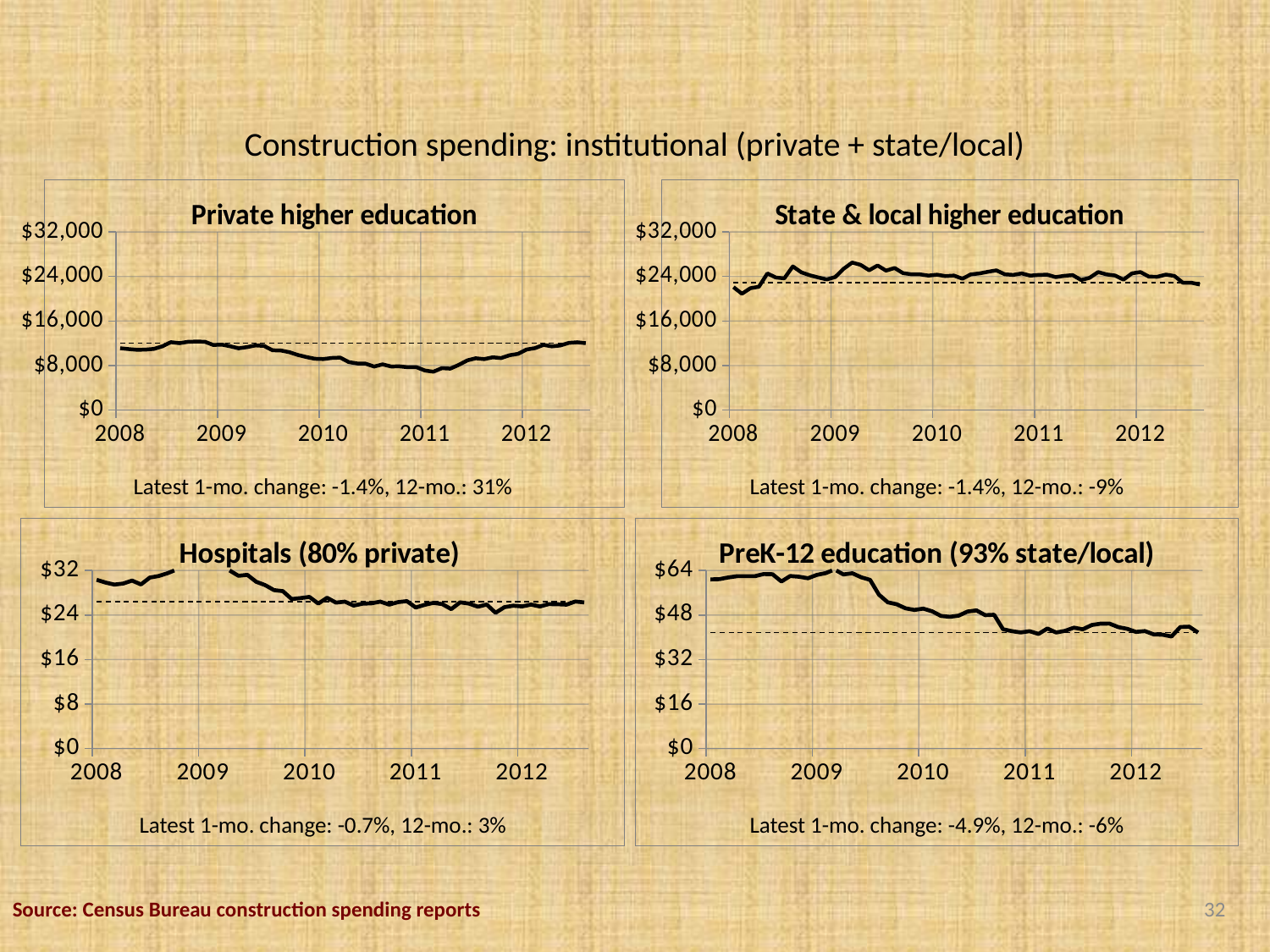
In the 'State & local higher education' chart, is the value at the start of 2010 greater or less than $16,000? greater What is the title of the chart in the bottom-left position of the slide? Hospitals (80% private) In the 'Hospitals (80% private)' chart, do values generally rise or fall from 2008 to 2012? fall In the 'Private higher education' chart, is the value at the start of 2008 greater or less than $8,000? greater What kind of chart is the 'Private higher education' chart? line chart In the 'PreK-12 education (93% state/local)' chart, is the value at the start of 2012 greater or less than $48? less What is the latest 12-month change reported under the 'Private higher education' chart? 31% How many charts are shown on the slide? 4 In the 'PreK-12 education (93% state/local)' chart, do values generally rise or fall from 2008 to 2012? fall